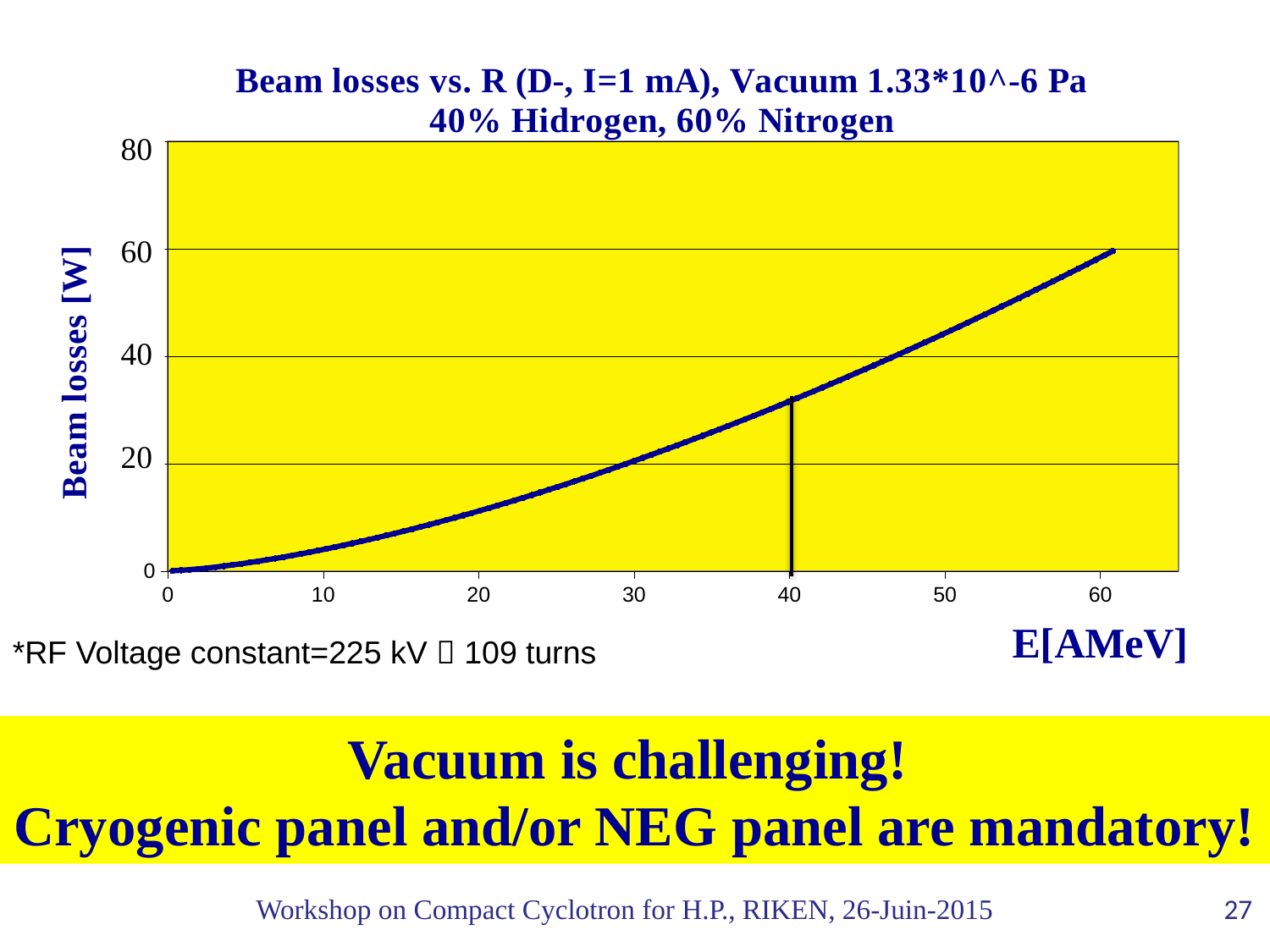
Is the beam loss value at E = 10 AMeV greater or less than 20 W? less What is the label of the y axis? Beam losses [W] Do the beam losses rise or fall as E[AMeV] increases along the x axis? rise Is the beam loss value at E = 50 AMeV greater or less than 40 W? greater Is the beam loss value at E = 20 AMeV greater or less than 20 W? less What kind of chart is shown on the slide? line chart What is the highest value shown on the y axis? 80 Which has the larger beam loss: E = 20 AMeV or E = 50 AMeV? E = 50 AMeV